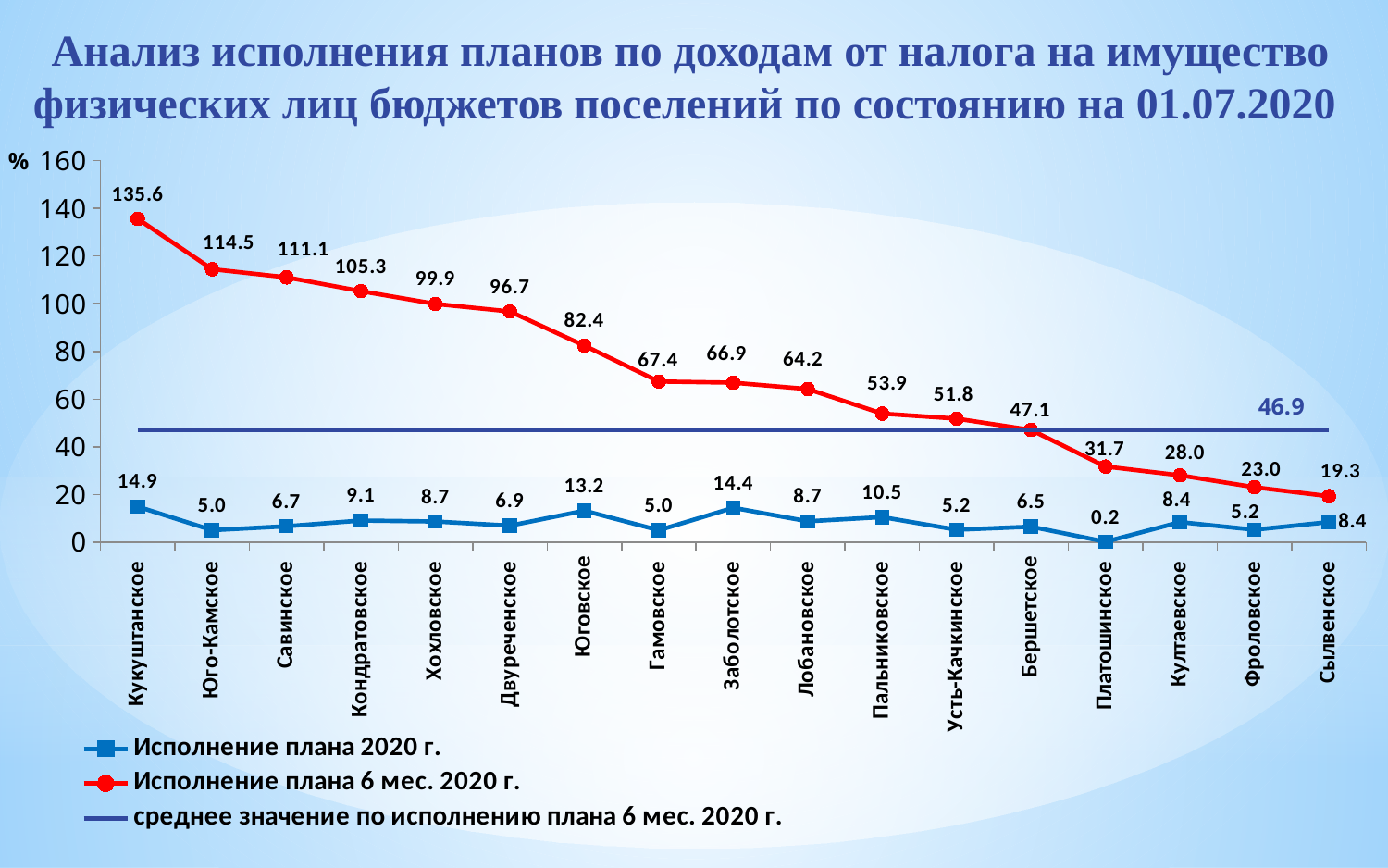
What is the difference between the 'Исполнение плана 6 мес. 2020 г.' values for Кукуштанское and Юго-Камское? 21.1 Which settlement has the lowest value for 'Исполнение плана 2020 г.'? Платошинское How many settlements (categories) are plotted along the x axis? 17 Which settlement has the lowest value for 'Исполнение плана 6 мес. 2020 г.'? Сылвенское What is the value of 'Исполнение плана 6 мес. 2020 г.' for Кукуштанское? 135.6 Does the 'Исполнение плана 6 мес. 2020 г.' series rise or fall from left to right along the x axis? fall Which is larger: the 'Исполнение плана 2020 г.' value for Юговское or for Пальниковское? Юговское What type of chart is shown on the slide? line chart What value is shown for the average line 'среднее значение по исполнению плана 6 мес. 2020 г.'? 46.9 What is the value of 'Исполнение плана 2020 г.' for Заболотское? 14.4 How many entries does the legend list? 3 What is the value of 'Исполнение плана 6 мес. 2020 г.' for Платошинское? 31.7